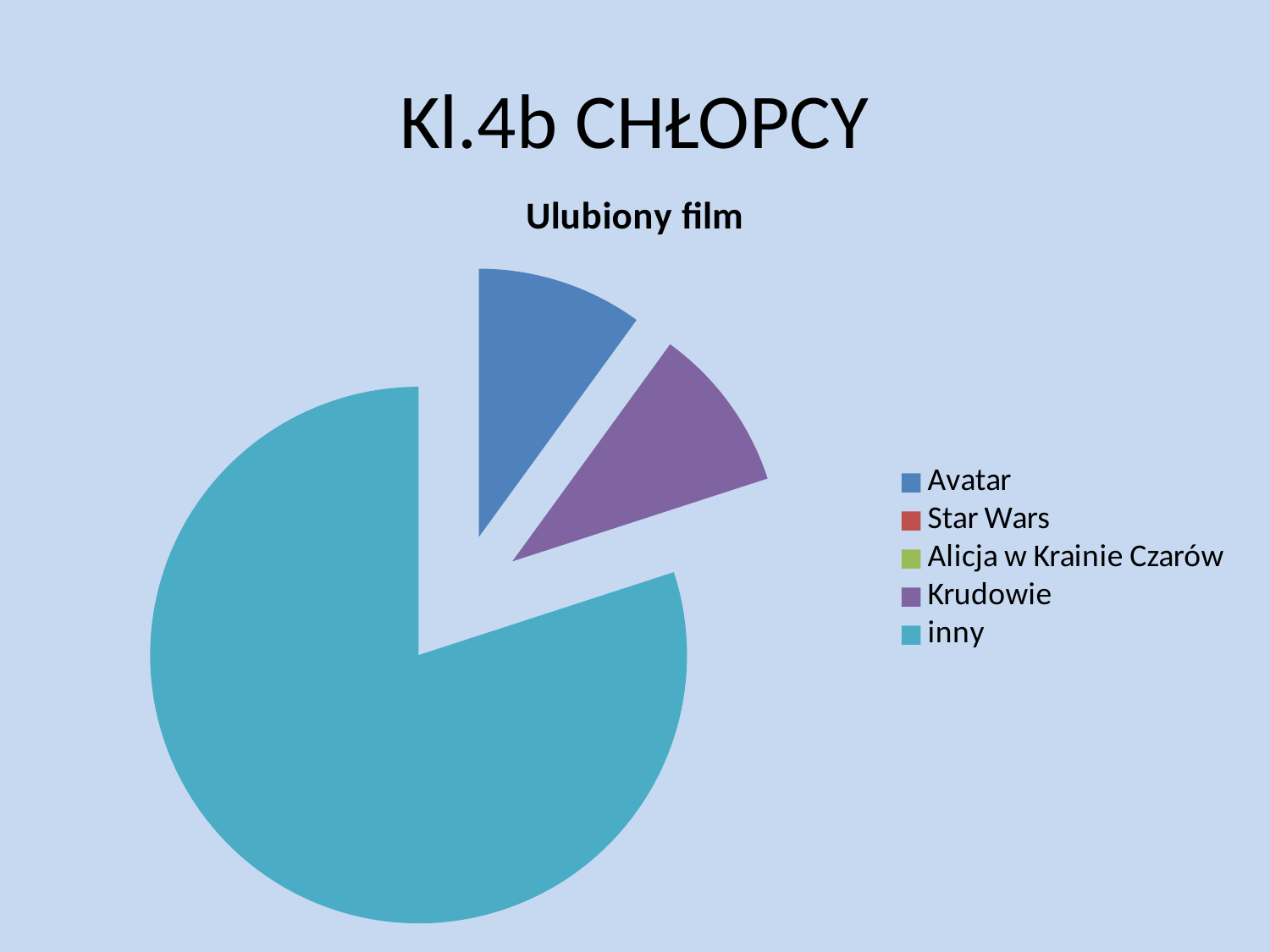
Is the share of the Avatar slice greater or less than 25%? less Which colour represents the category inny in the chart? teal Which category has the largest slice of the pie? inny How many entries does the chart's legend list? 5 Which slice is larger, inny or Krudowie? inny How many slices are visibly drawn in the pie? 3 What kind of chart is shown on the slide? pie chart Is the share of the inny slice greater or less than 50%? greater What is the title of the chart? Ulubiony film Is the share of the Krudowie slice greater or less than 25%? less Which slice is larger, inny or Avatar? inny